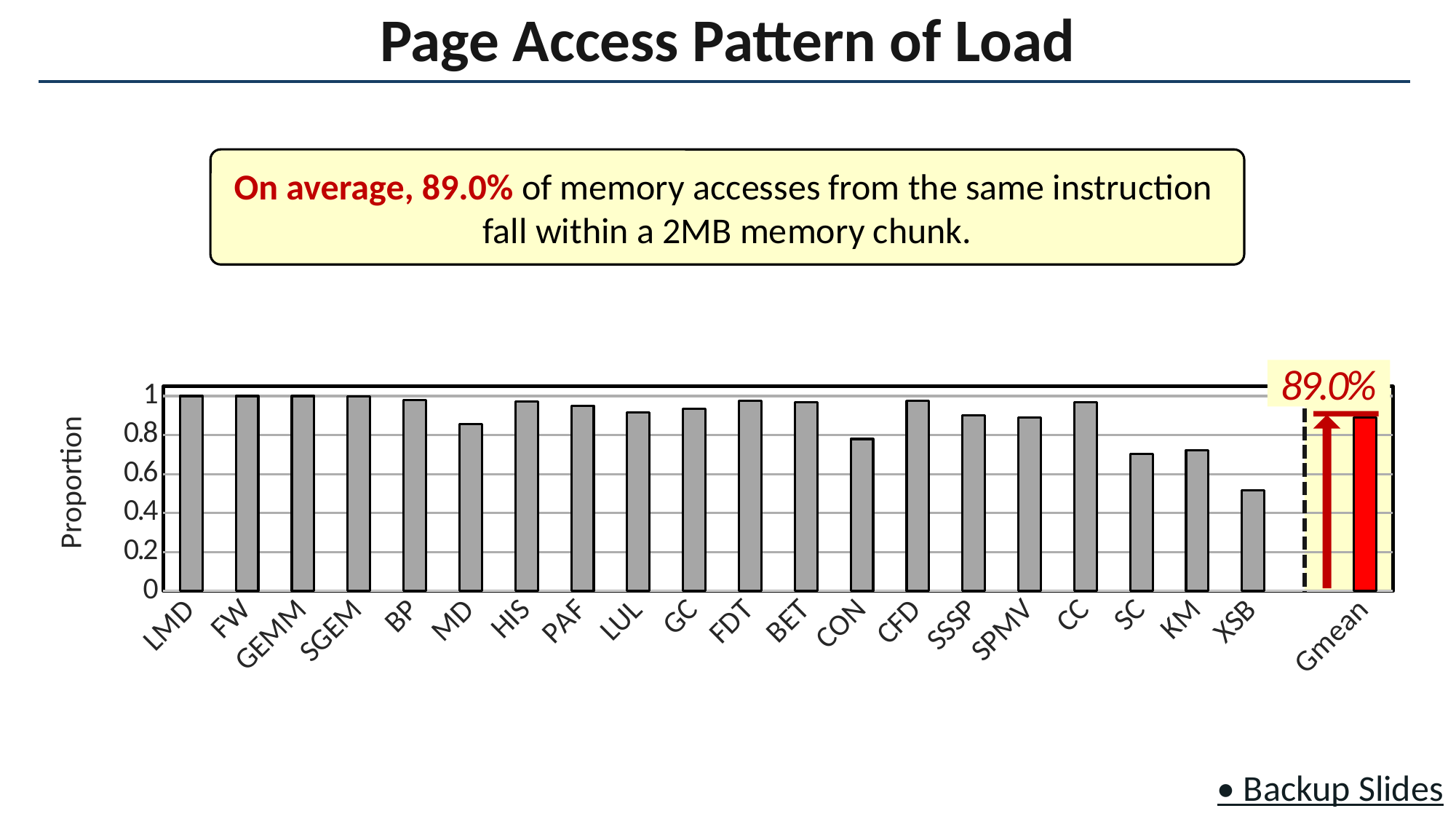
Which has the larger proportion, SC or XSB? SC How many categories are shown on the x axis, including Gmean? 21 Which has the larger proportion, LMD or CON? LMD Is the value for KM greater or less than 0.8? less Is the value for XSB greater or less than 0.6? less What value is labelled on the Gmean bar? 89.0% What kind of chart is shown on the slide? bar chart Is the value for SC greater or less than 0.8? less Which bar is coloured red rather than grey? Gmean Which category has the lowest proportion? XSB What is the label of the y axis? Proportion